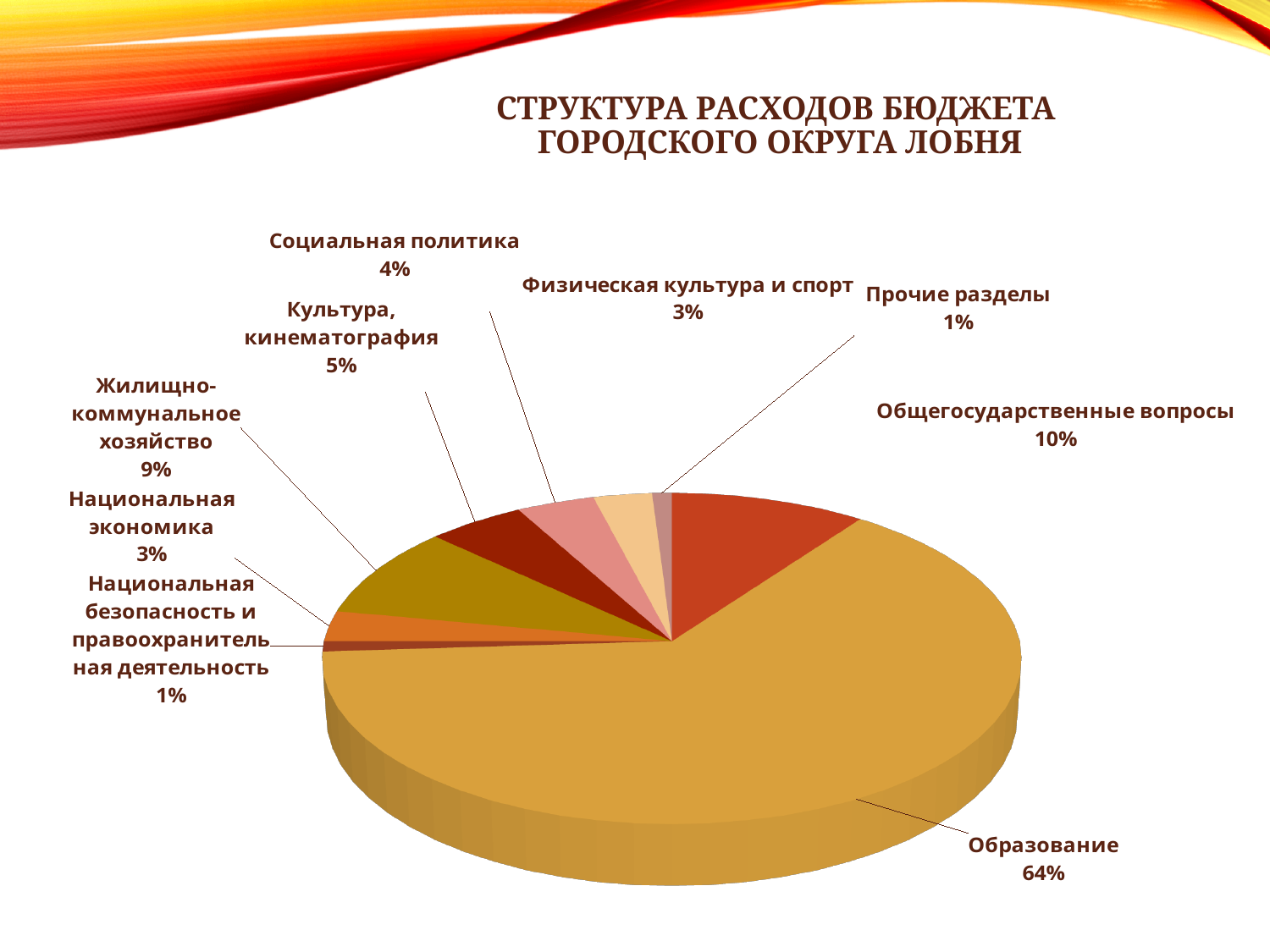
What is the value shown for Жилищно-коммунальное хозяйство? 9% What is the value shown for Общегосударственные вопросы? 10% What is the difference between the shares of Образование and Общегосударственные вопросы? 54% What is the value shown for Социальная политика? 4% Which category has the largest slice of the pie? Образование What is the value shown for Культура, кинематография? 5% How many categories are shown in the pie chart? 9 What is the title of the chart? СТРУКТУРА РАСХОДОВ БЮДЖЕТА ГОРОДСКОГО ОКРУГА ЛОБНЯ Which is larger, the share for Жилищно-коммунальное хозяйство or the share for Культура, кинематография? Жилищно-коммунальное хозяйство What share of the pie does Образование take? 64% What kind of chart is shown on the slide? pie chart What is the value shown for Физическая культура и спорт? 3%